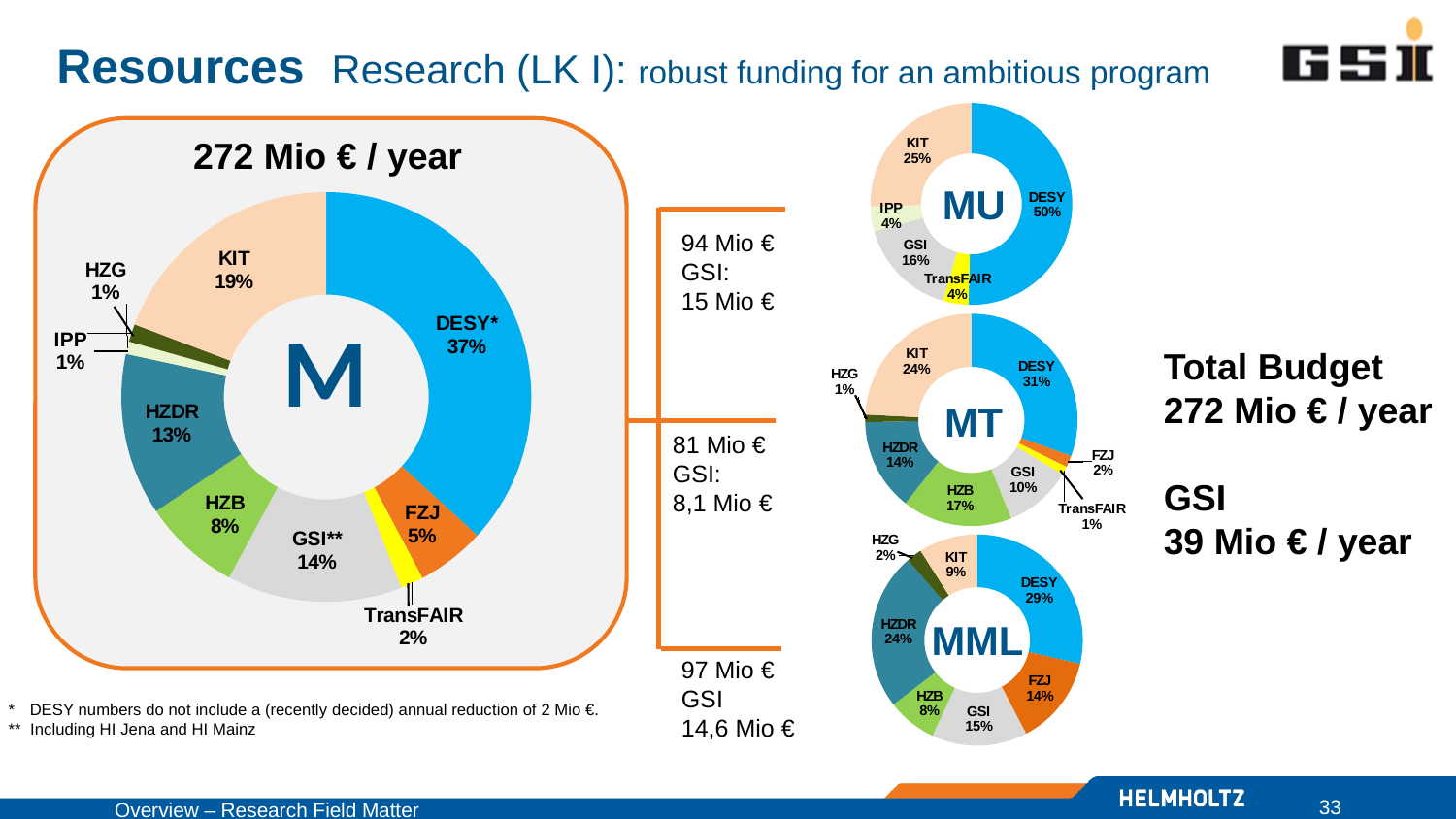
In the 'MML' doughnut chart, what share does HZDR have? 24% What type of chart is used for the 'MU' chart? Doughnut (pie) chart In the large 'M' doughnut chart, what share does GSI** have? 14% In the 'MT' doughnut chart, which institution has the largest share? DESY In the large 'M' doughnut chart, what is the difference in percentage points between KIT and HZDR? 6 percentage points In the large 'M' doughnut chart, which institution has the largest share? DESY* How many institutions are shown as slices in the large 'M' doughnut chart? 9 In the large 'M' doughnut chart, which is larger, the share of HZB or the share of FZJ? HZB In the 'MU' doughnut chart, what share does DESY have? 50% In the 'MML' doughnut chart, what is the difference in percentage points between DESY and FZJ? 15 percentage points In the 'MU' doughnut chart, what share does KIT have? 25% In the large 'M' doughnut chart (272 Mio € / year), what share does DESY* have? 37%